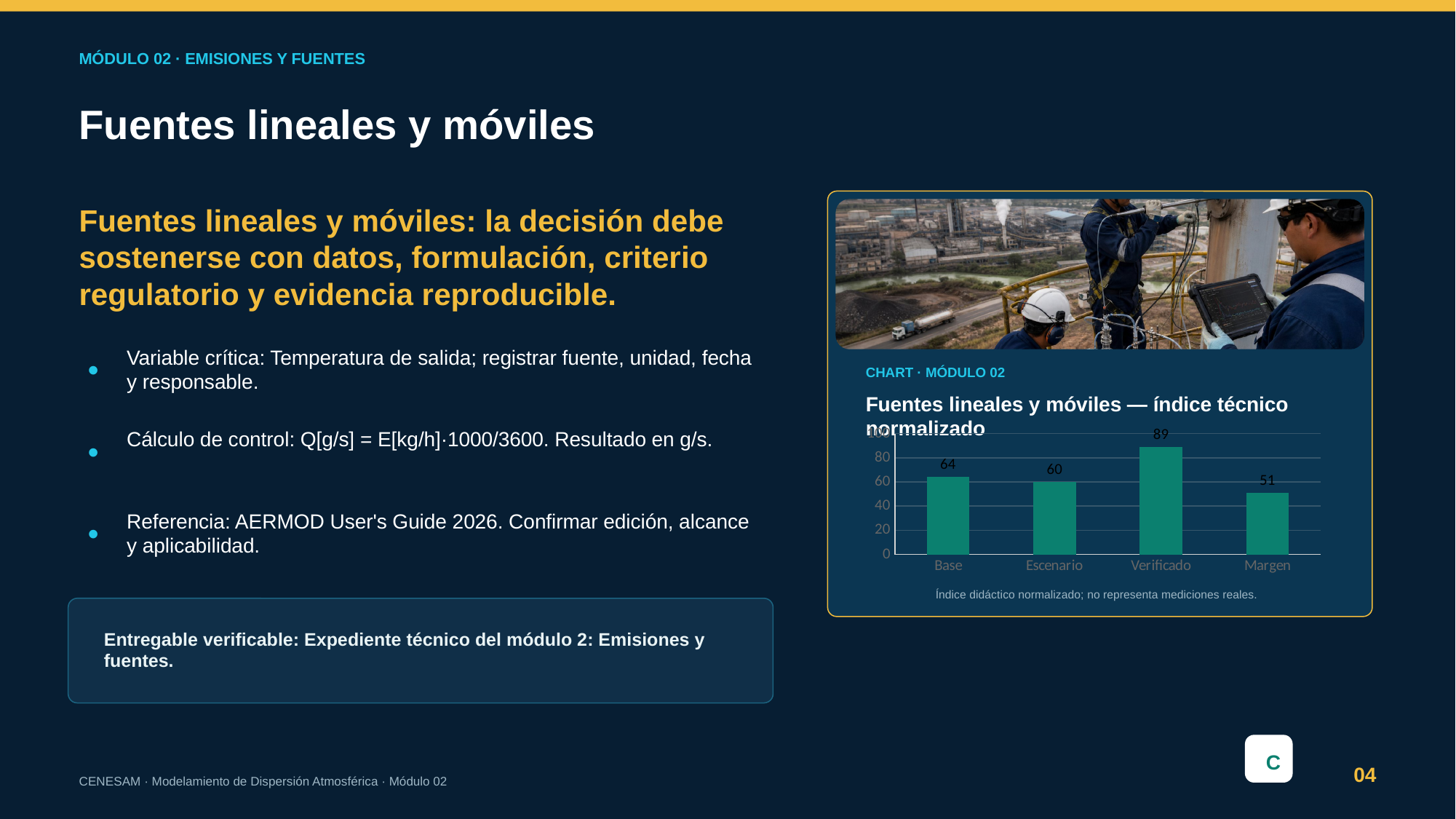
Is the value for Verificado greater or less than 80? greater Which category has the lowest value? Margen Which category has the highest value? Verificado How many categories are shown on the x axis? 4 What is the value for Escenario? 60 What is the title of the chart? Fuentes lineales y móviles — índice técnico normalizado What is the difference between the values for Verificado and Margen? 38 Which is larger, the value for Base or the value for Escenario? Base What is the value for Base? 64 What is the value for Margen? 51 What kind of chart is shown on the slide? bar chart What is the value for Verificado? 89